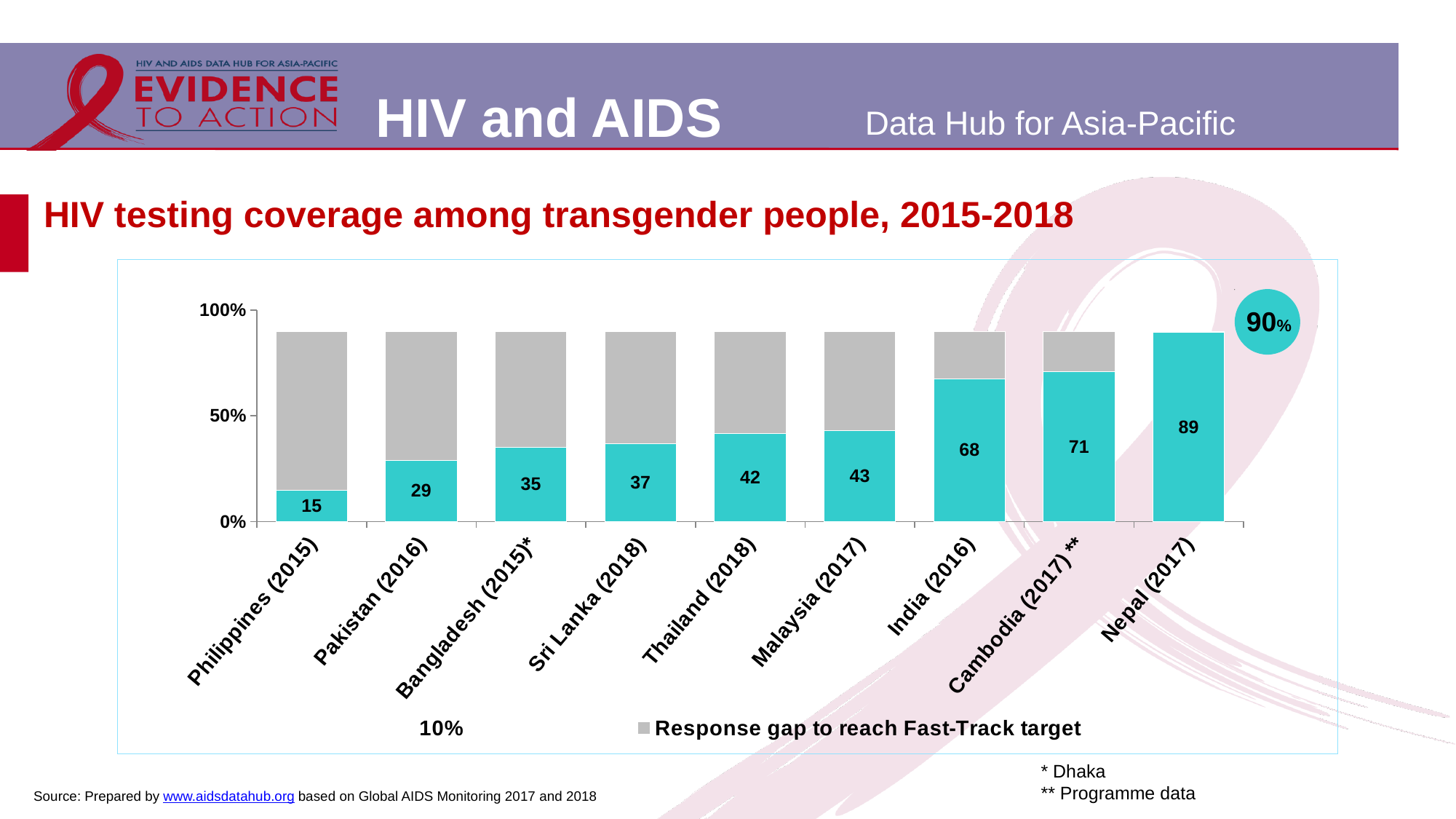
Which country has the highest HIV testing coverage value on the chart? Nepal (2017) What kind of chart is used to show HIV testing coverage among transgender people? Stacked bar chart How many countries are shown on the x axis of the chart? 9 Is the HIV testing coverage value for Bangladesh (2015) greater or less than 50%? less What does the grey segment of each bar represent, according to the legend? Response gap to reach Fast-Track target What is the difference between the HIV testing coverage values for Nepal (2017) and Philippines (2015)? 74 Which has a higher HIV testing coverage value, Pakistan (2016) or Sri Lanka (2018)? Sri Lanka (2018) What is the difference between the HIV testing coverage values for Malaysia (2017) and Thailand (2018)? 1 What is the HIV testing coverage value shown for India (2016)? 68 Which country has the lowest HIV testing coverage value on the chart? Philippines (2015) What is the HIV testing coverage value shown for Cambodia (2017)? 71 What is the HIV testing coverage value shown for Philippines (2015)? 15